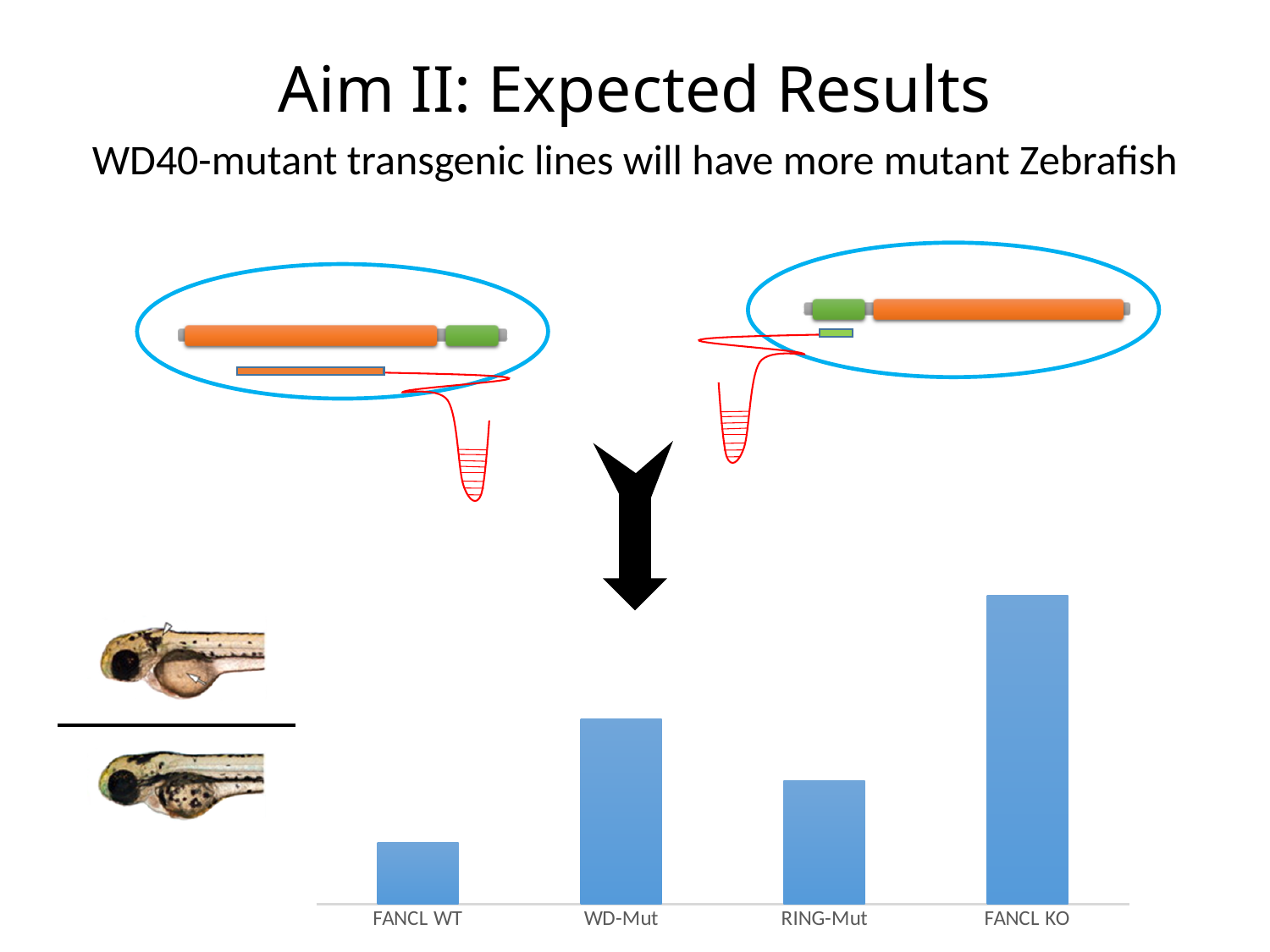
Which bar is taller, WD-Mut or RING-Mut? WD-Mut What colour are the bars in the chart? blue What kind of chart is shown at the bottom of the slide? bar chart Which bar is taller, FANCL WT or WD-Mut? WD-Mut Which category has the shortest bar in the chart? FANCL WT Which category has the tallest bar in the chart? FANCL KO Which bar is taller, FANCL WT or RING-Mut? RING-Mut Which category has the second tallest bar in the chart? WD-Mut How many categories are shown on the x axis of the bar chart? 4 What is the label of the first category on the x axis of the bar chart? FANCL WT